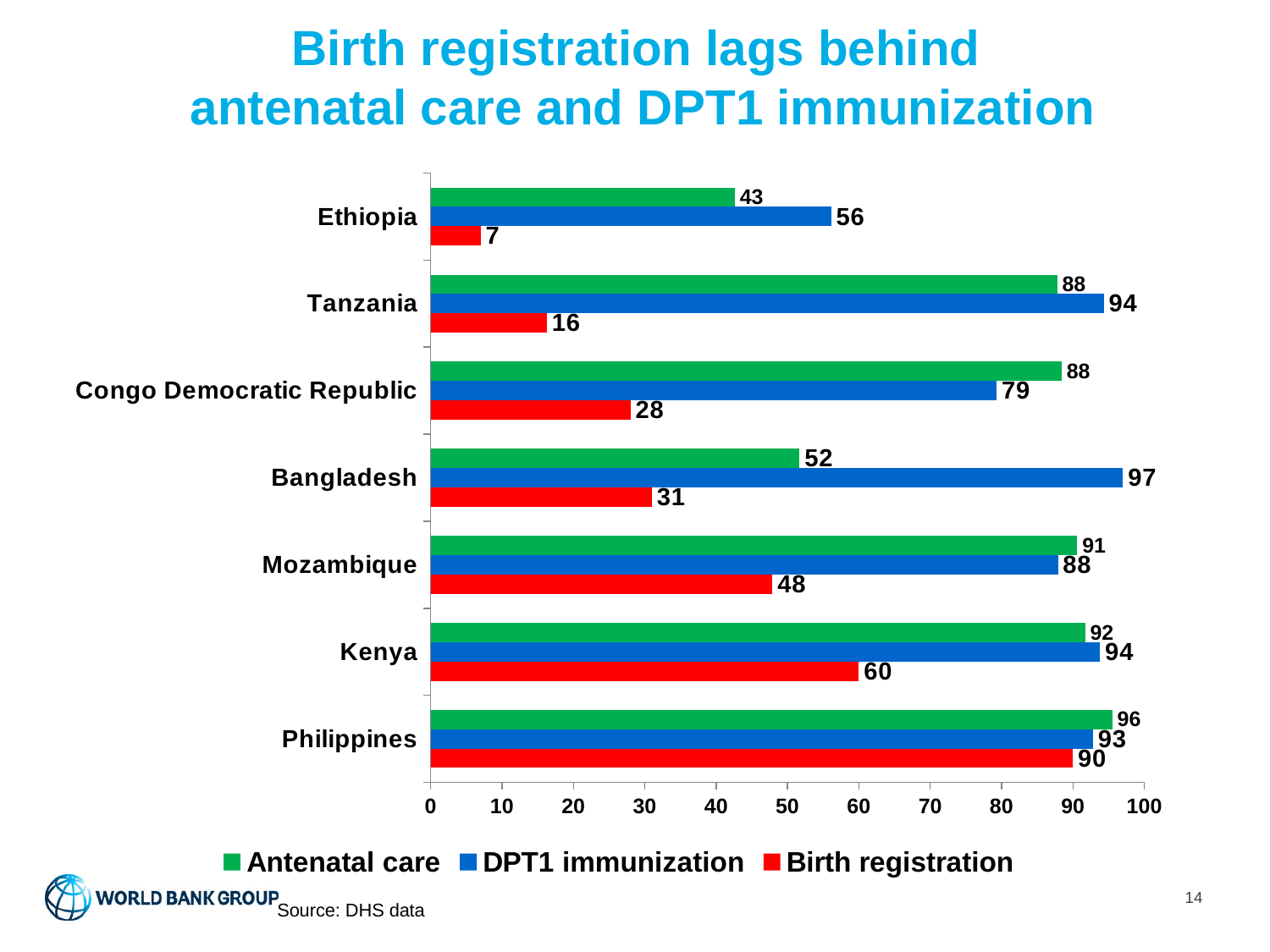
What is the difference between the DPT1 immunization and Birth registration values for Tanzania? 78 What kind of chart is shown on the slide? Bar chart Which colour represents Birth registration in the chart? Red How many countries are shown on the chart? 7 What is the Antenatal care value for Kenya? 92 How many series does the legend list? 3 Which country has the highest Birth registration value? Philippines What is the Birth registration value for Ethiopia? 7 Which country has the lowest Antenatal care value? Ethiopia What is the DPT1 immunization value for Bangladesh? 97 Which is larger for Congo Democratic Republic: Antenatal care or DPT1 immunization? Antenatal care What is the Birth registration value for Mozambique? 48